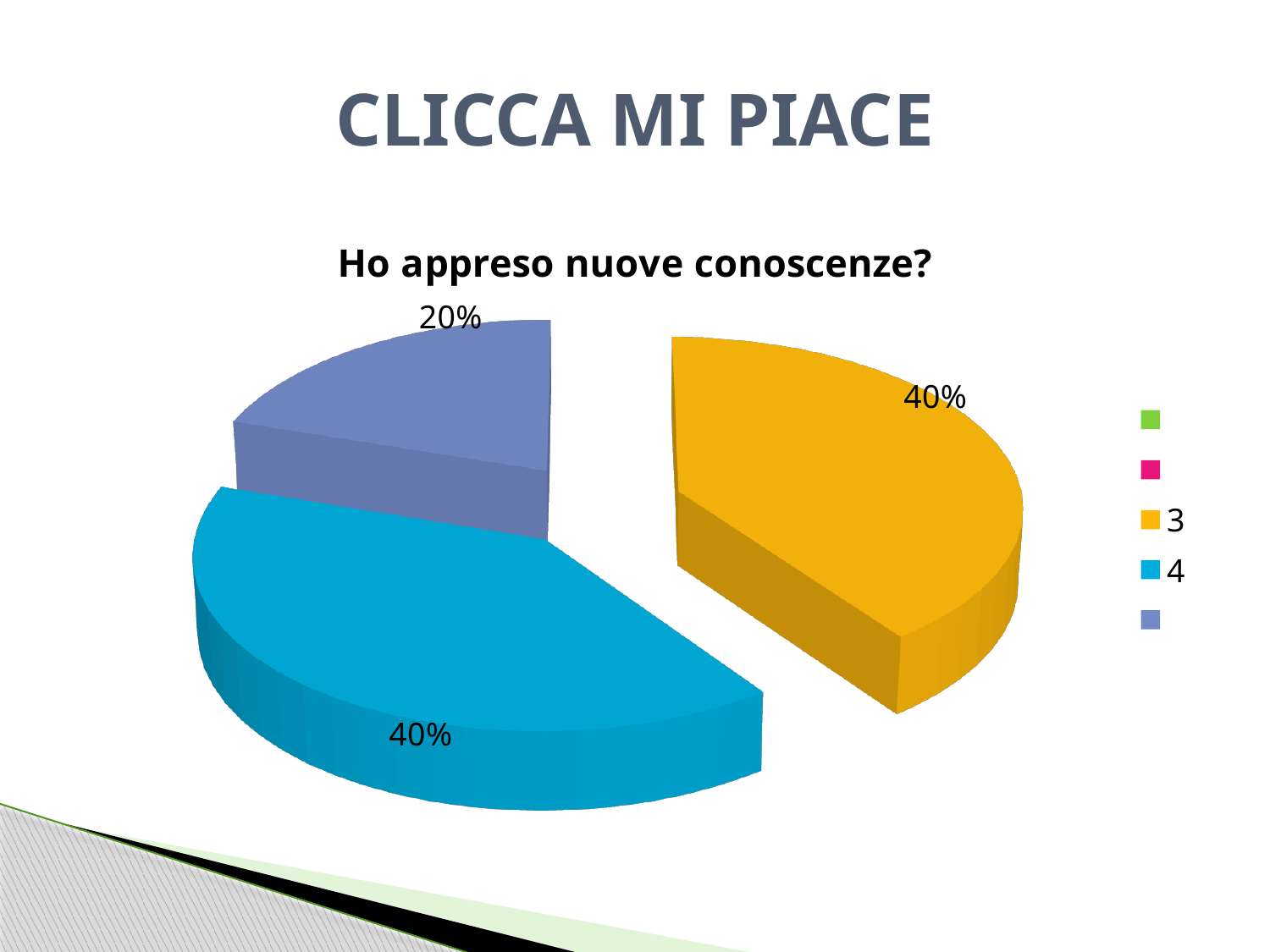
What kind of chart is shown on the slide? pie chart What is the title of the pie chart? Ho appreso nuove conoscenze? What is the difference between the share for category 3 and the smallest slice (20%)? 20% What is the share of the pie for category 4? 40% What is the largest percentage shown on the pie chart? 40% What colour is the slice for category 3? yellow How many entries does the legend list? 5 Is the share for category 4 greater or less than 30%? greater What percentage of the pie does category 4 represent? 40% How many slices does the pie chart have? 3 What percentage of the pie does category 3 represent? 40% What is the smallest percentage shown on the pie chart? 20%